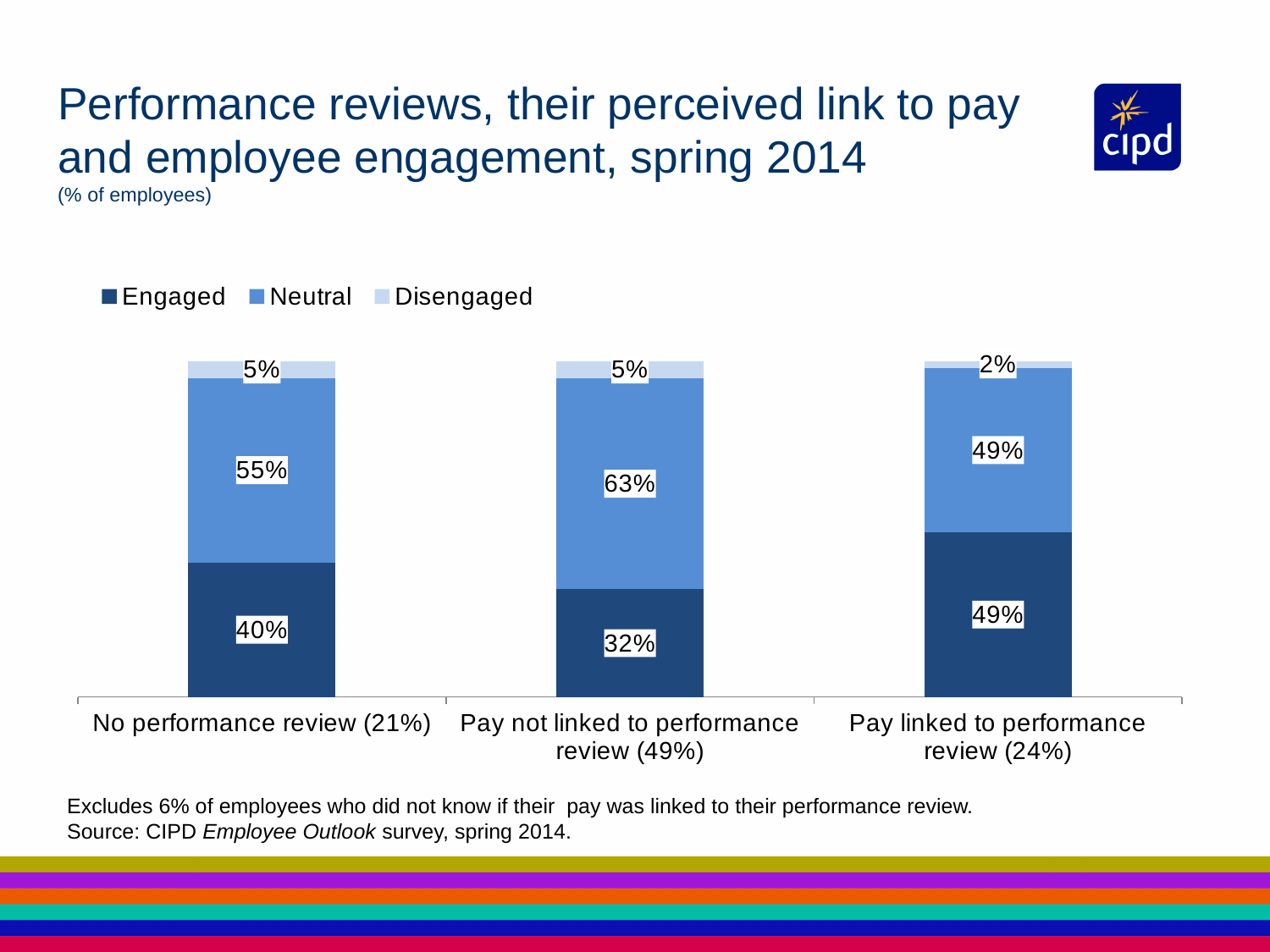
What is the Disengaged value for employees whose pay is linked to their performance review? 2% What percentage of employees with no performance review are Engaged? 40% How many categories are shown on the x axis? 3 Which category has the lowest Engaged percentage? Pay not linked to performance review (49%) What is the difference between the Engaged percentage for 'Pay linked to performance review' and 'Pay not linked to performance review'? 17 percentage points What is the total of the stacked bar for 'No performance review'? 100% Which category has the highest Engaged percentage? Pay linked to performance review (24%) Is the Neutral value larger for 'No performance review' or for 'Pay not linked to performance review'? Pay not linked to performance review What is the Neutral value for employees whose pay is not linked to their performance review? 63% How many series does the legend list? 3 Which series is shown in the darkest blue colour? Engaged What kind of chart is shown on the slide? Stacked bar chart